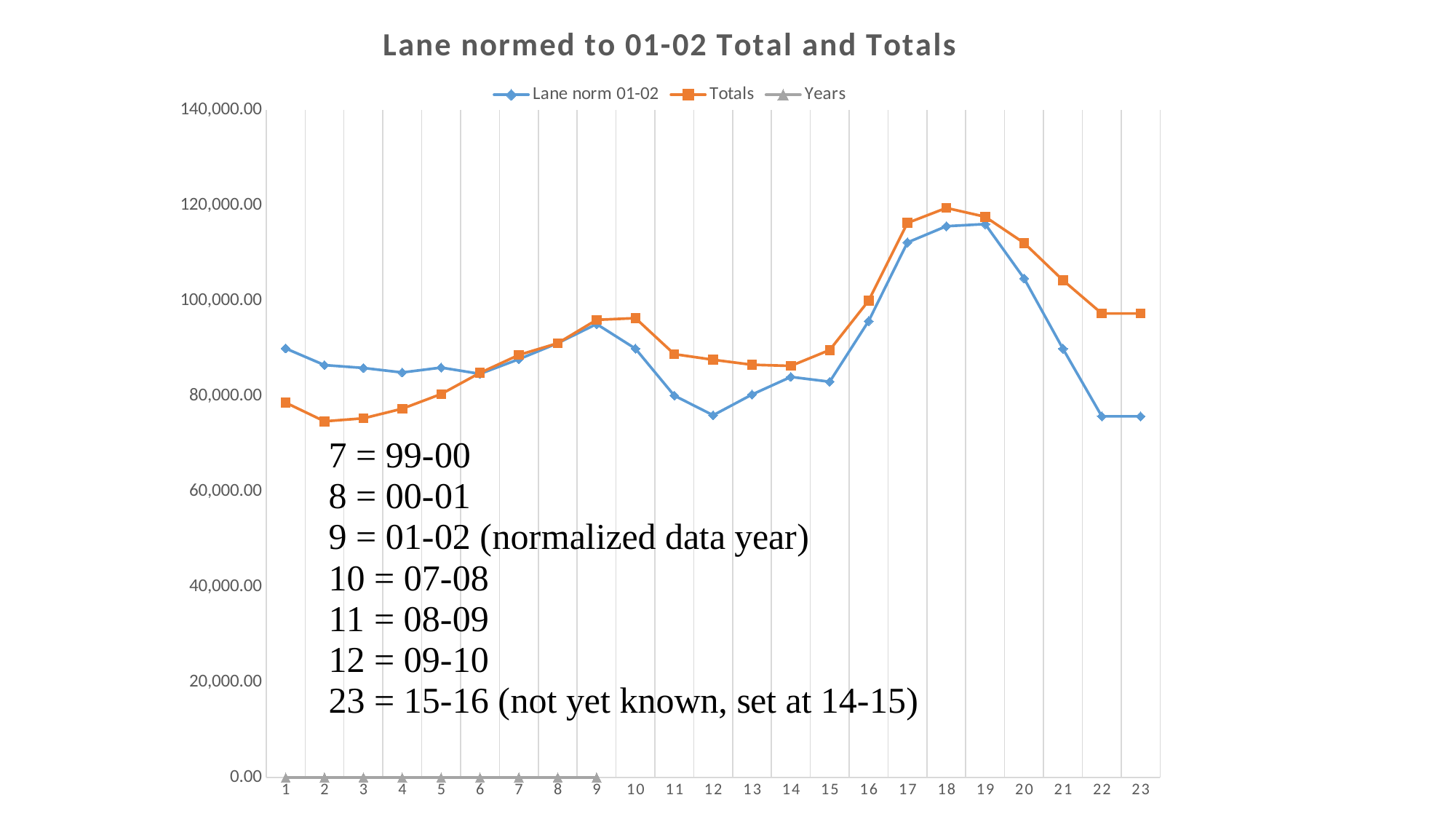
How many points are labelled along the x axis? 23 Is the Totals value at point 18 greater or less than 100,000.00? greater At point 1, which series has the larger value, Lane norm 01-02 or Totals? Lane norm 01-02 At point 12, which series has the larger value, Lane norm 01-02 or Totals? Totals What is the title of the chart? Lane normed to 01-02 Total and Totals Is the Lane norm 01-02 value at point 12 greater or less than 80,000.00? less Is the Totals value at point 2 greater or less than 80,000.00? less How many series does the legend list? 3 What kind of chart is shown on the slide? Line chart Does the Totals series rise or fall from point 14 to point 18? Rise At which x-axis point does the Totals series reach its highest value? 18